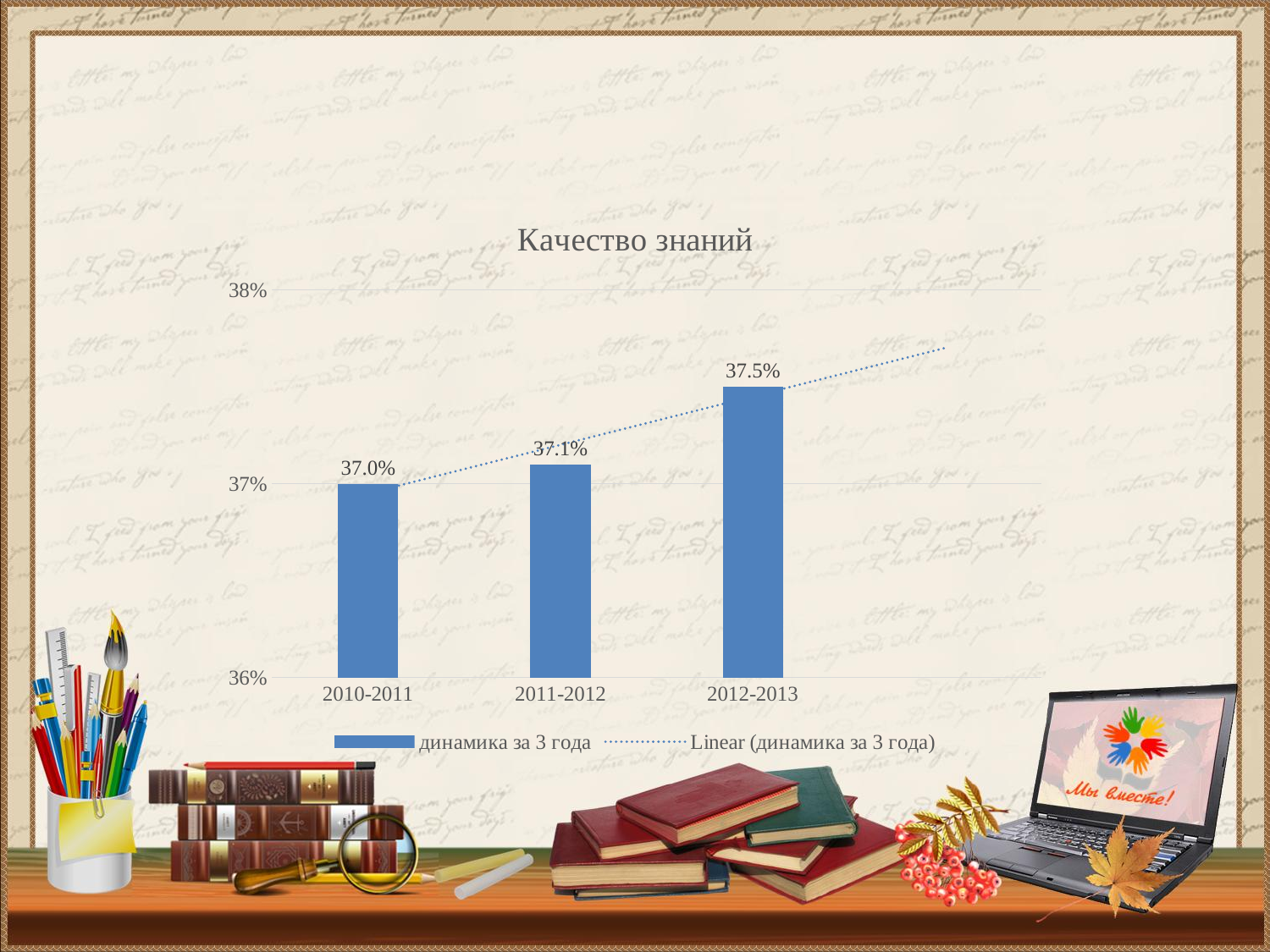
What kind of chart is this? bar chart What is the value for 2010-2011? 37.0% Which is larger, the value for 2011-2012 or the value for 2012-2013? 2012-2013 Do the values rise or fall from 2010-2011 to 2012-2013? rise What is the difference between the values for 2012-2013 and 2010-2011? 0.5% What is the value for 2011-2012? 37.1% Which year has the lowest value? 2010-2011 What is the value for 2012-2013? 37.5% What is the title of the chart? Качество знаний What is the difference between the values for 2012-2013 and 2011-2012? 0.4% Which year has the highest value? 2012-2013 How many categories are shown on the x axis? 3